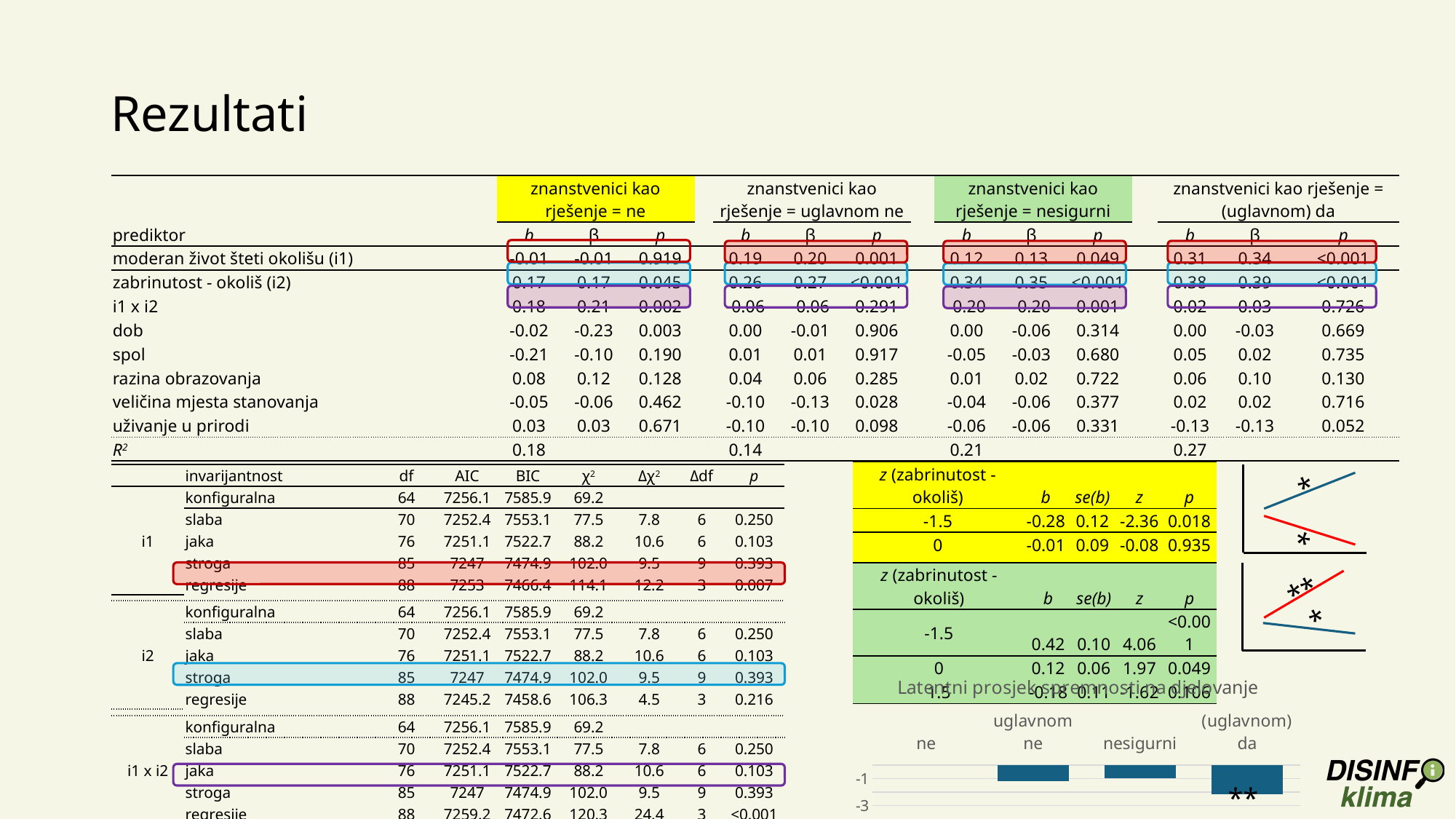
In the 'Latentni prosjek spremnosti na djelovanje' bar chart, which category has no visible bar? ne In the 'Latentni prosjek spremnosti na djelovanje' bar chart, which category has the longest bar? (uglavnom) da What is the title of the bar chart at the bottom right of the slide? Latentni prosjek spremnosti na djelovanje How many categories are shown on the x axis of the 'Latentni prosjek spremnosti na djelovanje' bar chart? 4 In the 'Latentni prosjek spremnosti na djelovanje' bar chart, is the value for '(uglavnom) da' greater or less than -1? less What kind of chart is the chart titled 'Latentni prosjek spremnosti na djelovanje' at the bottom right of the slide? bar chart In the 'Latentni prosjek spremnosti na djelovanje' bar chart, what are the two tick values shown on the vertical axis? -1 and -3